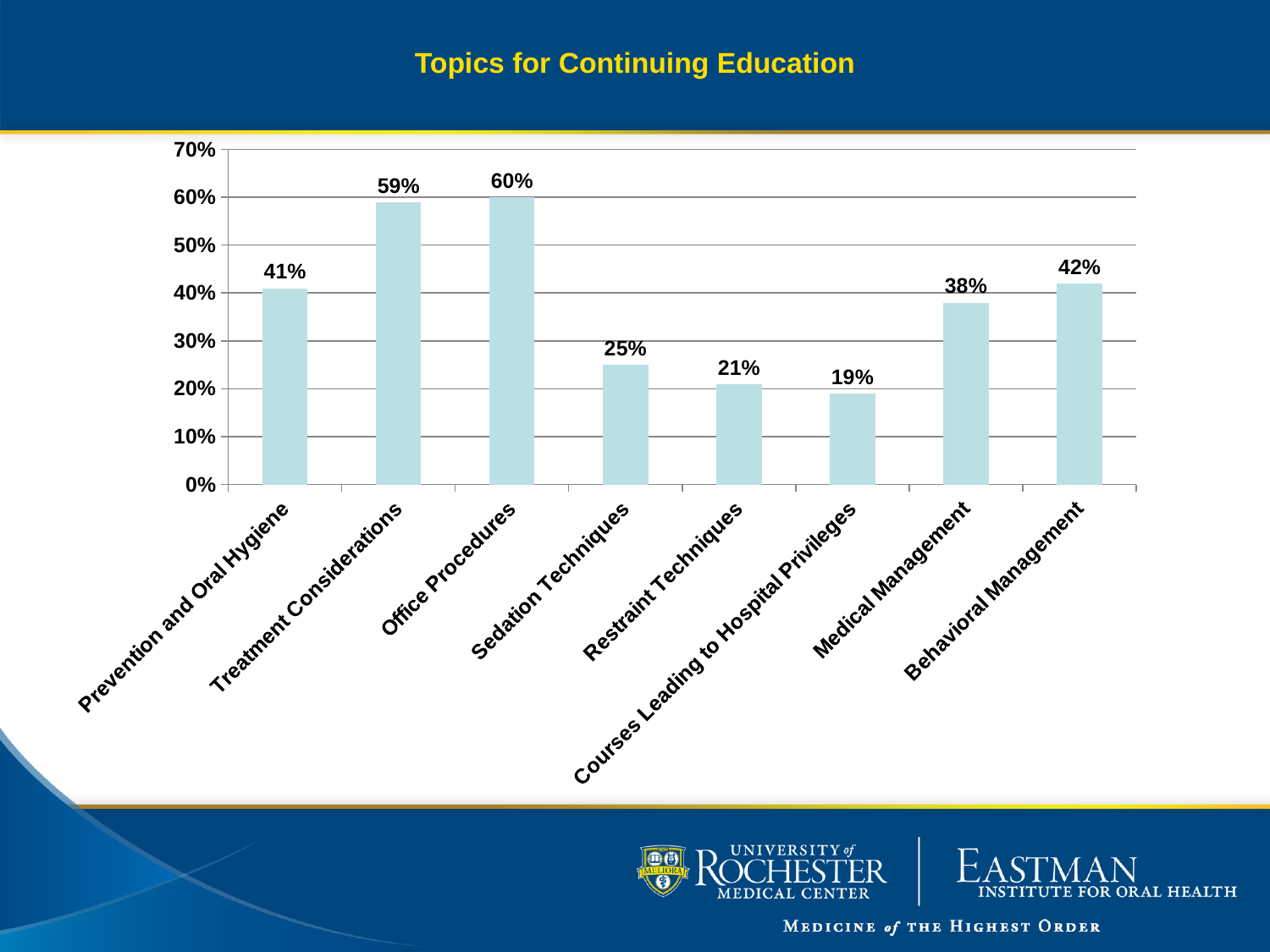
What is the difference between the values for Office Procedures and Courses Leading to Hospital Privileges? 41% Which is larger, the value for Behavioral Management or the value for Prevention and Oral Hygiene? Behavioral Management Which category has the lowest value? Courses Leading to Hospital Privileges Which category has the highest value? Office Procedures What is the value for Office Procedures? 60% What is the title of the slide? Topics for Continuing Education What kind of chart is shown on the slide? bar chart What is the difference between the values for Treatment Considerations and Sedation Techniques? 34% How many categories are shown on the chart? 8 What is the value for Medical Management? 38% What is the value for Courses Leading to Hospital Privileges? 19% Is the value for Restraint Techniques greater or less than 30%? less